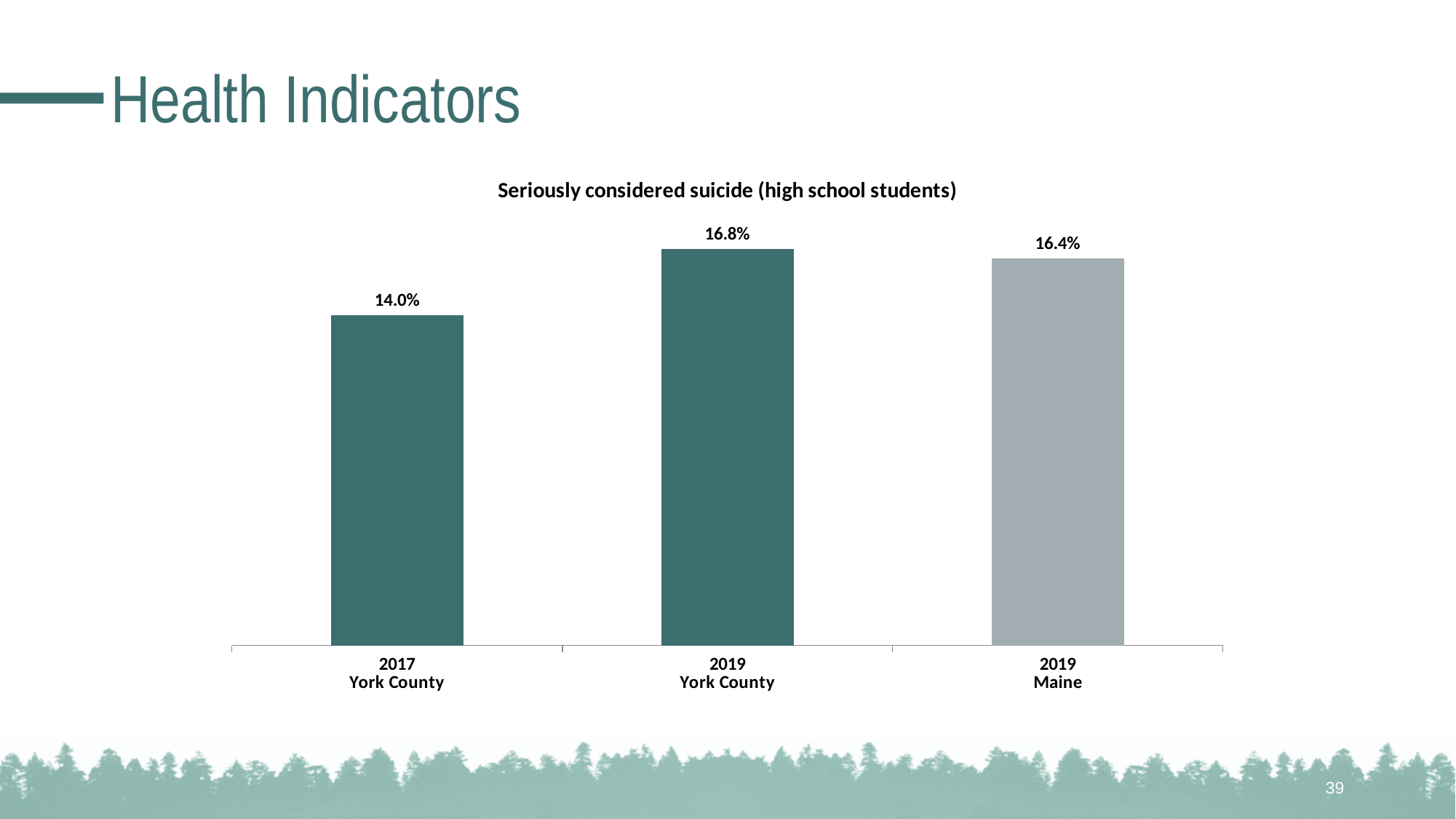
What is the difference between the 2019 York County value and the 2017 York County value? 2.8% What is the value for 2019 York County? 16.8% What is the difference between the 2019 York County value and the 2019 Maine value? 0.4% Did the York County value rise or fall from 2017 to 2019? Rise What is the value for 2017 York County? 14.0% What kind of chart is shown on the slide? Bar chart Which category has the highest value? 2019 York County What is the title of the chart? Seriously considered suicide (high school students) What is the value for 2019 Maine? 16.4% Which category has the lowest value? 2017 York County How many bars are shown in the chart? 3 Which is larger, the value for 2017 York County or the value for 2019 Maine? 2019 Maine